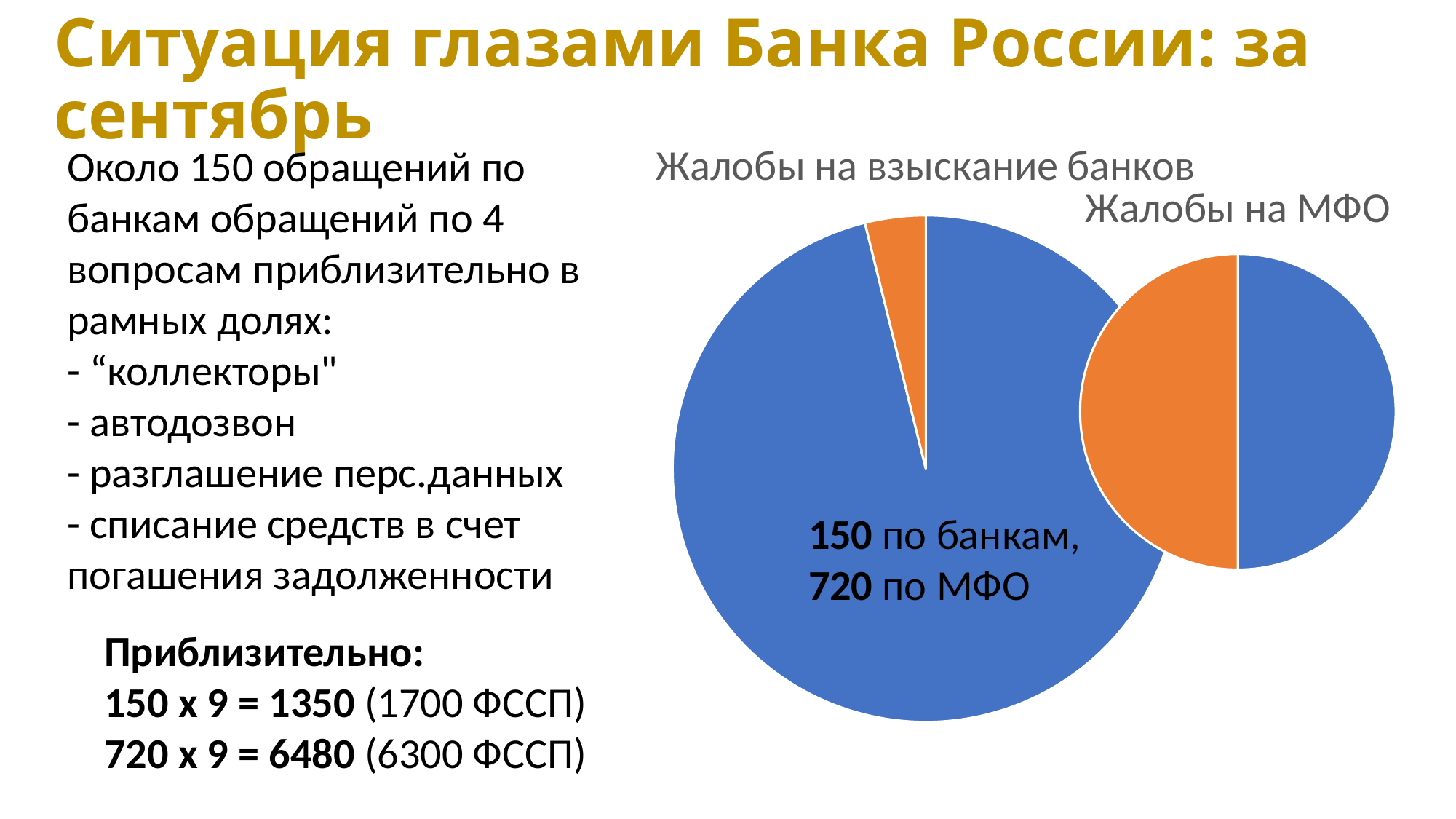
How many pie charts are shown on the slide? 2 What is the title of the larger pie chart on the left? Жалобы на взыскание банков How many slices does the "Жалобы на МФО" pie chart have? 2 What kind of chart is "Жалобы на взыскание банков"? pie chart In the "Жалобы на взыскание банков" pie chart, which slice is larger, the blue one or the orange one? the blue one What is the title of the smaller pie chart on the right? Жалобы на МФО In the "Жалобы на взыскание банков" pie chart, which slice is the smallest? the orange slice What kind of chart is "Жалобы на МФО"? pie chart How many slices does the "Жалобы на взыскание банков" pie chart have? 2